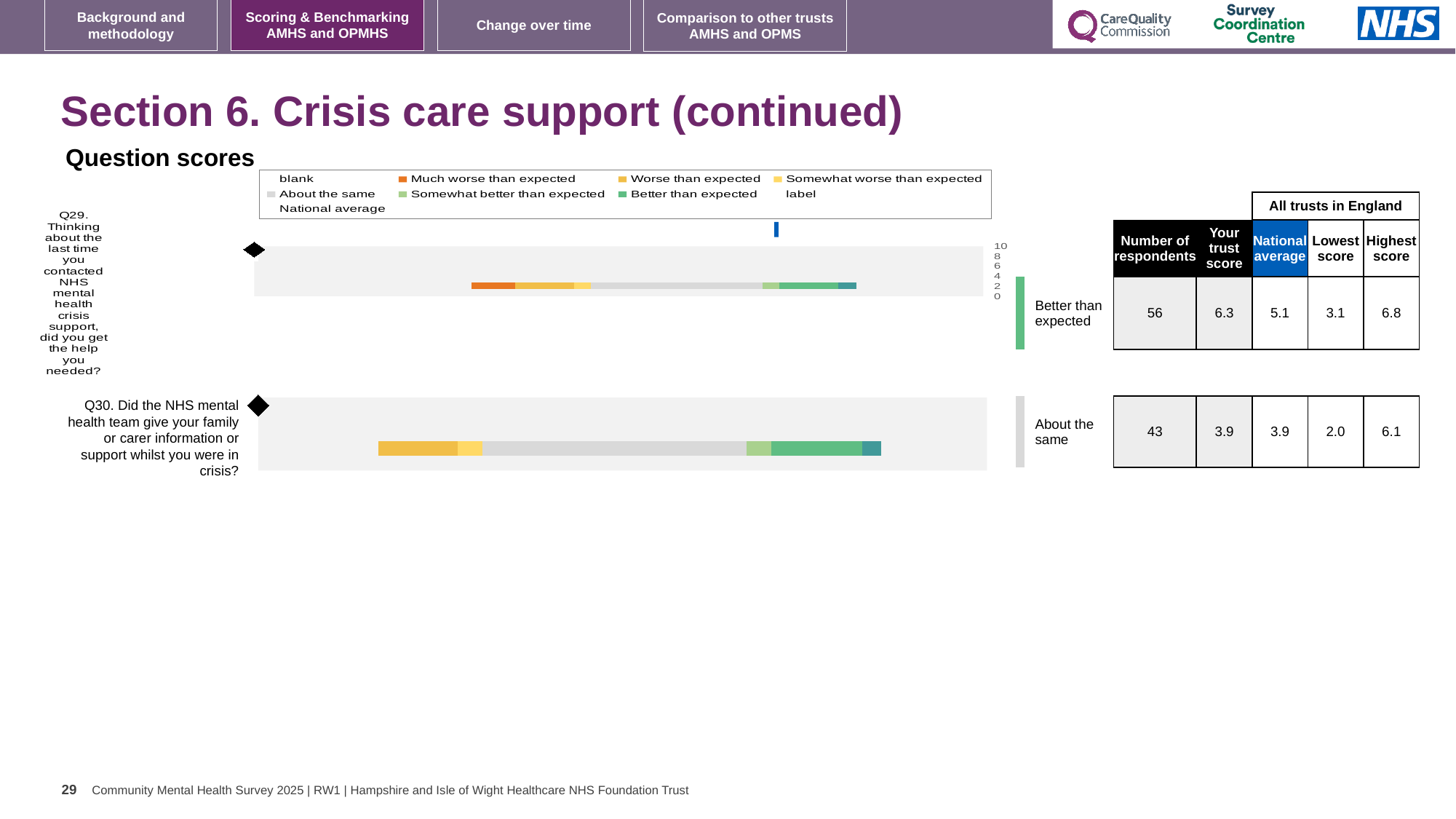
Which of the two questions in the chart has an orange 'Much worse than expected' segment in its bar? Q29 In the table beside the chart, what is the trust score for Q29? 6.3 What benchmark label is shown next to the Q30 bar in the question scores chart? About the same In the table beside the chart, how many respondents answered Q30? 43 What benchmark label is shown next to the Q29 bar in the question scores chart? Better than expected How many entries does the legend of the question scores chart list? 9 In the question scores chart legend, what colour represents 'Much worse than expected'? orange How many questions (bars) are plotted in the question scores chart? 2 For Q29, what is the difference between the highest score and the lowest score across all trusts in England? 3.7 For Q29, which is larger: the trust score or the national average? trust score In the table beside the chart, what is the national average for Q30? 3.9 What kind of chart is used to show the question scores for Q29 and Q30? bar chart